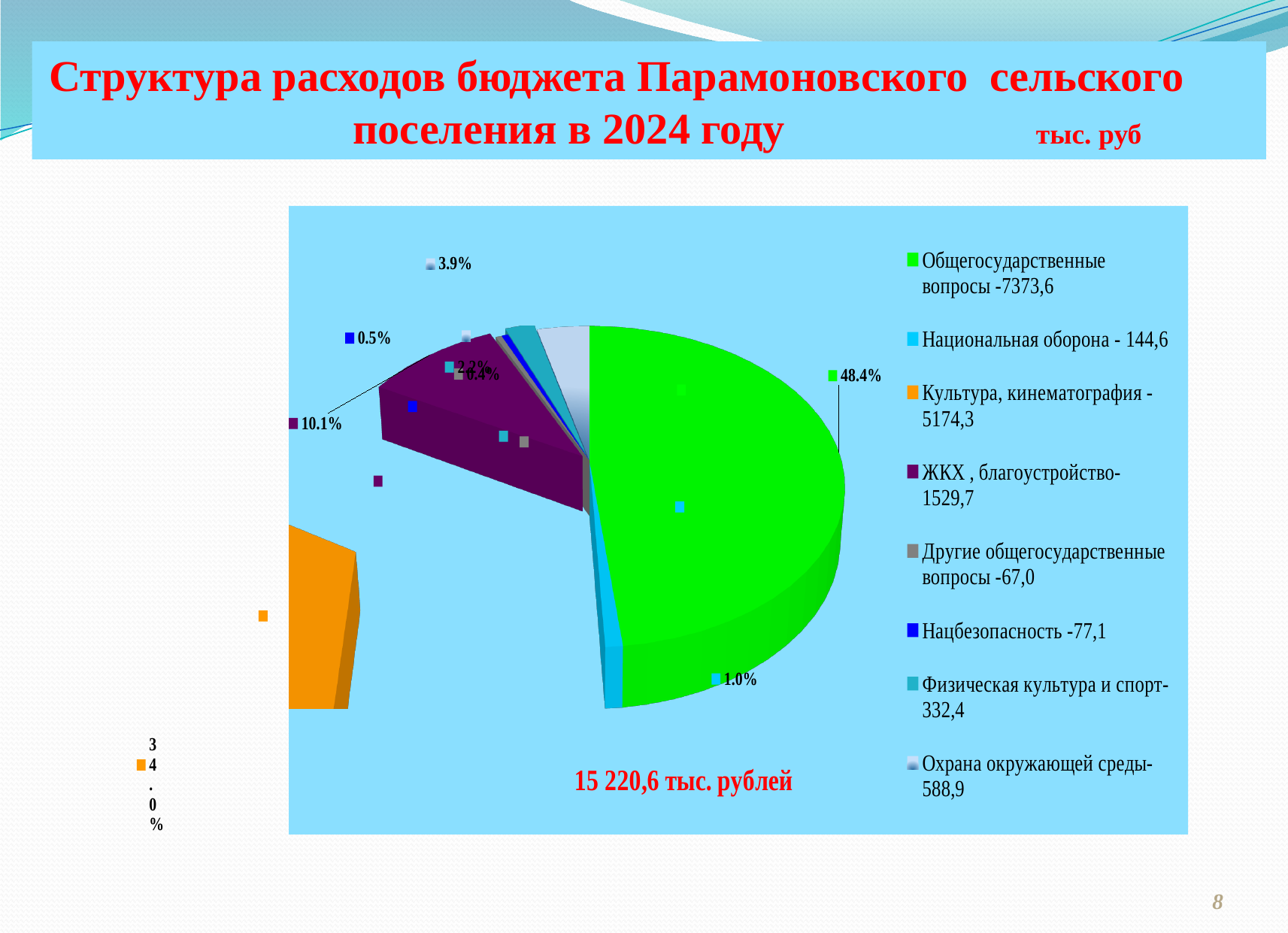
What is the value for Культура, кинематография? 5174,3 Which category has the smallest value? Другие общегосударственные вопросы What kind of chart is shown on the slide? pie chart What is the difference between the values for Общегосударственные вопросы and Культура, кинематография? 2199,3 What is the value for Общегосударственные вопросы? 7373,6 How many categories does the legend of the pie chart list? 8 What total amount is printed below the pie chart? 15 220,6 тыс. рублей What share of the pie does ЖКХ, благоустройство take? 10.1% What is the value for Физическая культура и спорт? 332,4 Which category has the largest value? Общегосударственные вопросы What share of the pie does Общегосударственные вопросы take? 48.4% Which is larger: the value for Нацбезопасность or the value for Национальная оборона? Национальная оборона